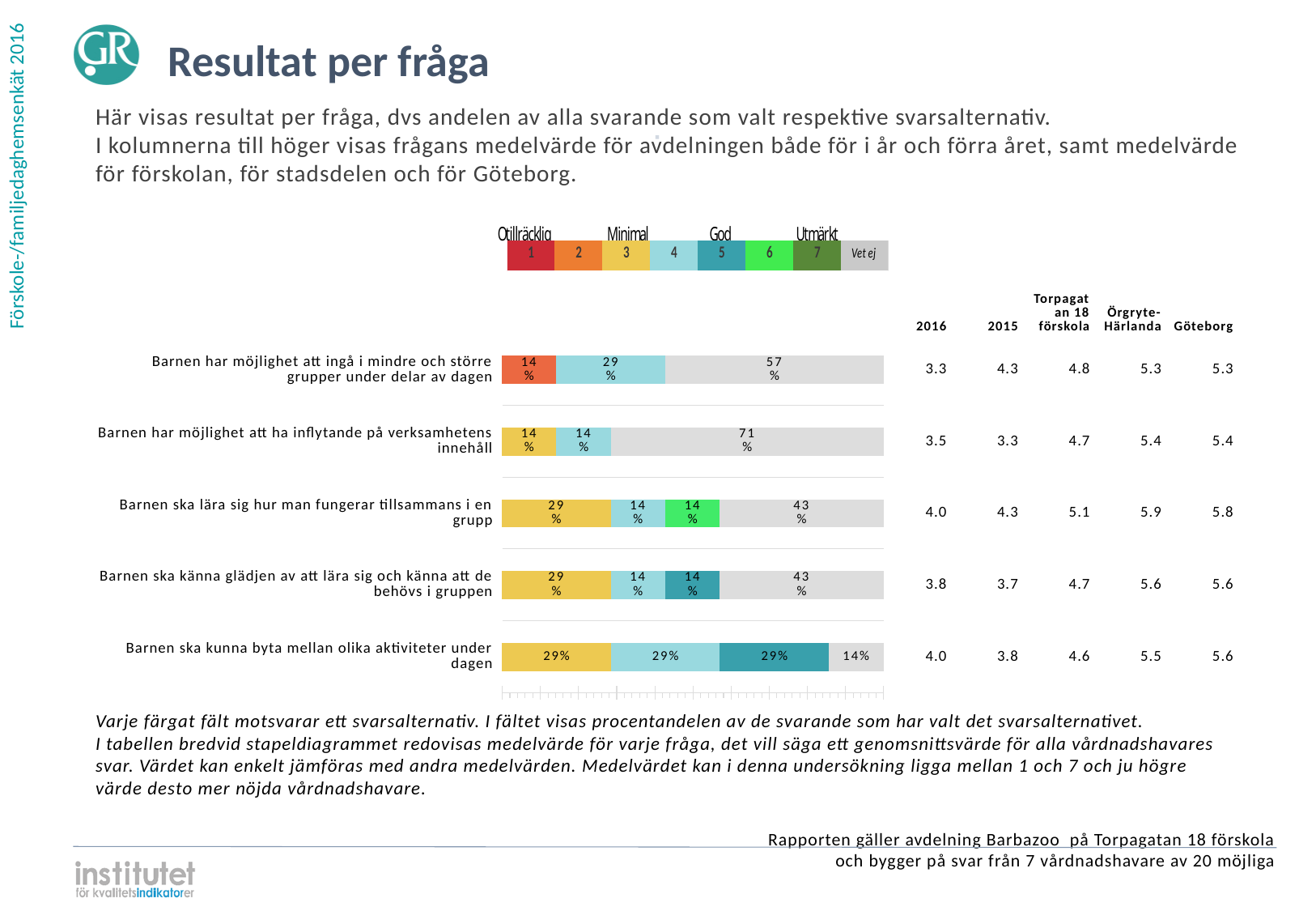
What is the grey 'Vet ej' share for 'Barnen ska kunna byta mellan olika aktiviteter under dagen'? 14% Which question has the smallest 'Vet ej' (grey) share? Barnen ska kunna byta mellan olika aktiviteter under dagen What colour represents the 'Vet ej' response option in the legend? Grey Which question has the largest 'Vet ej' (grey) share? Barnen har möjlighet att ha inflytande på verksamhetens innehåll What percentage of respondents answered 'Vet ej' for 'Barnen har möjlighet att ha inflytande på verksamhetens innehåll'? 71% How many response options does the colour legend above the chart list, including 'Vet ej'? 8 What kind of chart is used to show the results per question? Stacked bar chart What is the difference between the 'Vet ej' share for 'Barnen har möjlighet att ingå i mindre och större grupper under delar av dagen' (57%) and for 'Barnen ska lära sig hur man fungerar tillsammans i en grupp' (43%)? 14% How many questions (categories) are shown in the bar chart? 5 Is the 'Vet ej' share larger for 'Barnen har möjlighet att ingå i mindre och större grupper under delar av dagen' or for 'Barnen ska känna glädjen av att lära sig och känna att de behövs i gruppen'? Barnen har möjlighet att ingå i mindre och större grupper under delar av dagen What is the Göteborg mean value for 'Barnen har möjlighet att ingå i mindre och större grupper under delar av dagen'? 5.3 What is the 2016 mean value for 'Barnen ska lära sig hur man fungerar tillsammans i en grupp'? 4.0